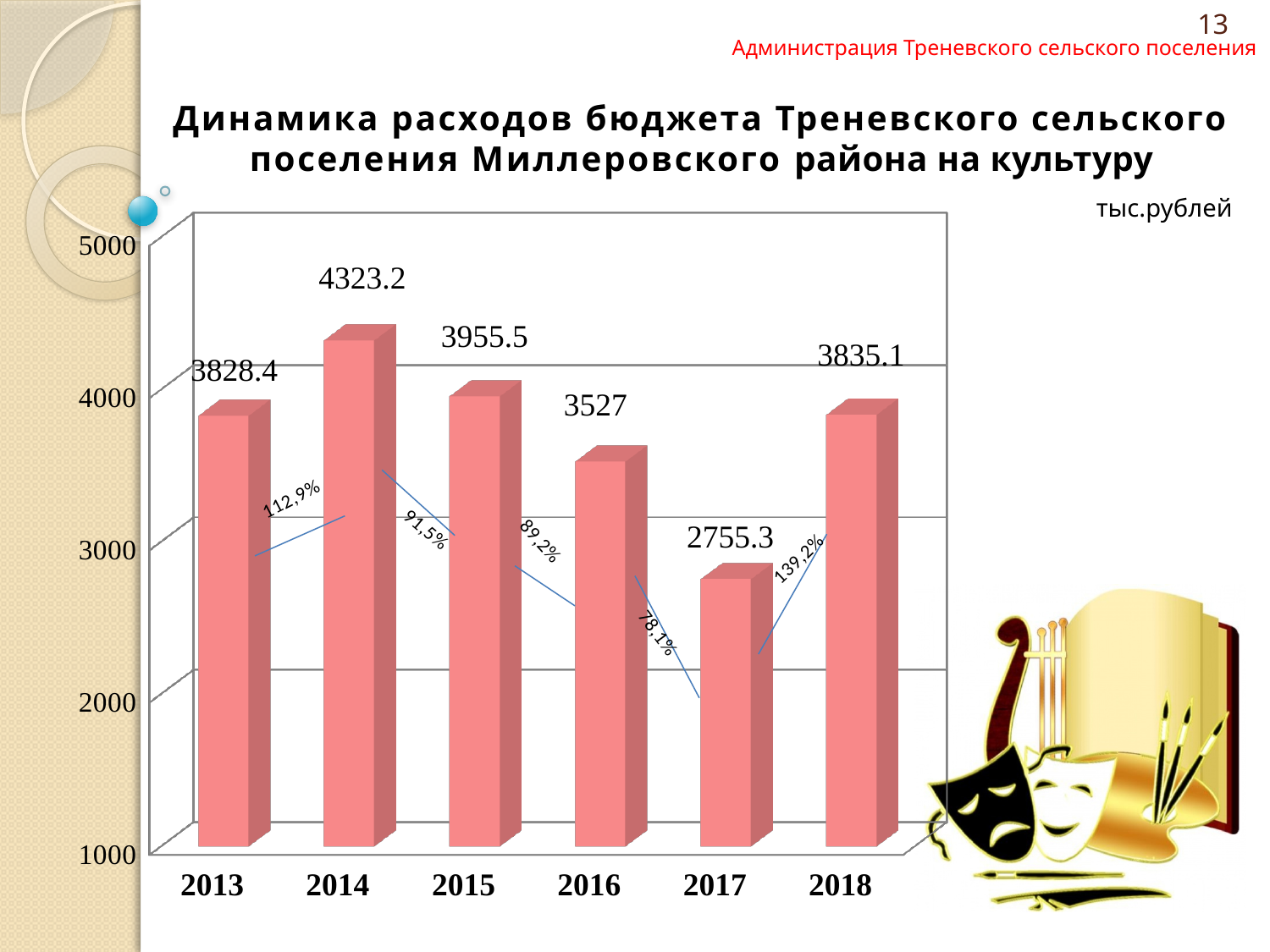
What kind of chart is this? bar chart What is the value for 2016? 3527 How many years are shown on the x axis? 6 What is the difference between the values for 2014 and 2013? 494.8 What unit is stated for the values on the chart? тыс.рублей Which year has the lowest value? 2017 What is the value for 2017? 2755.3 What is the value for 2018? 3835.1 Which is larger, the value for 2014 or the value for 2015? 2014 What is the difference between the values for 2018 and 2017? 1079.8 What is the value for 2014? 4323.2 Which year has the highest value? 2014